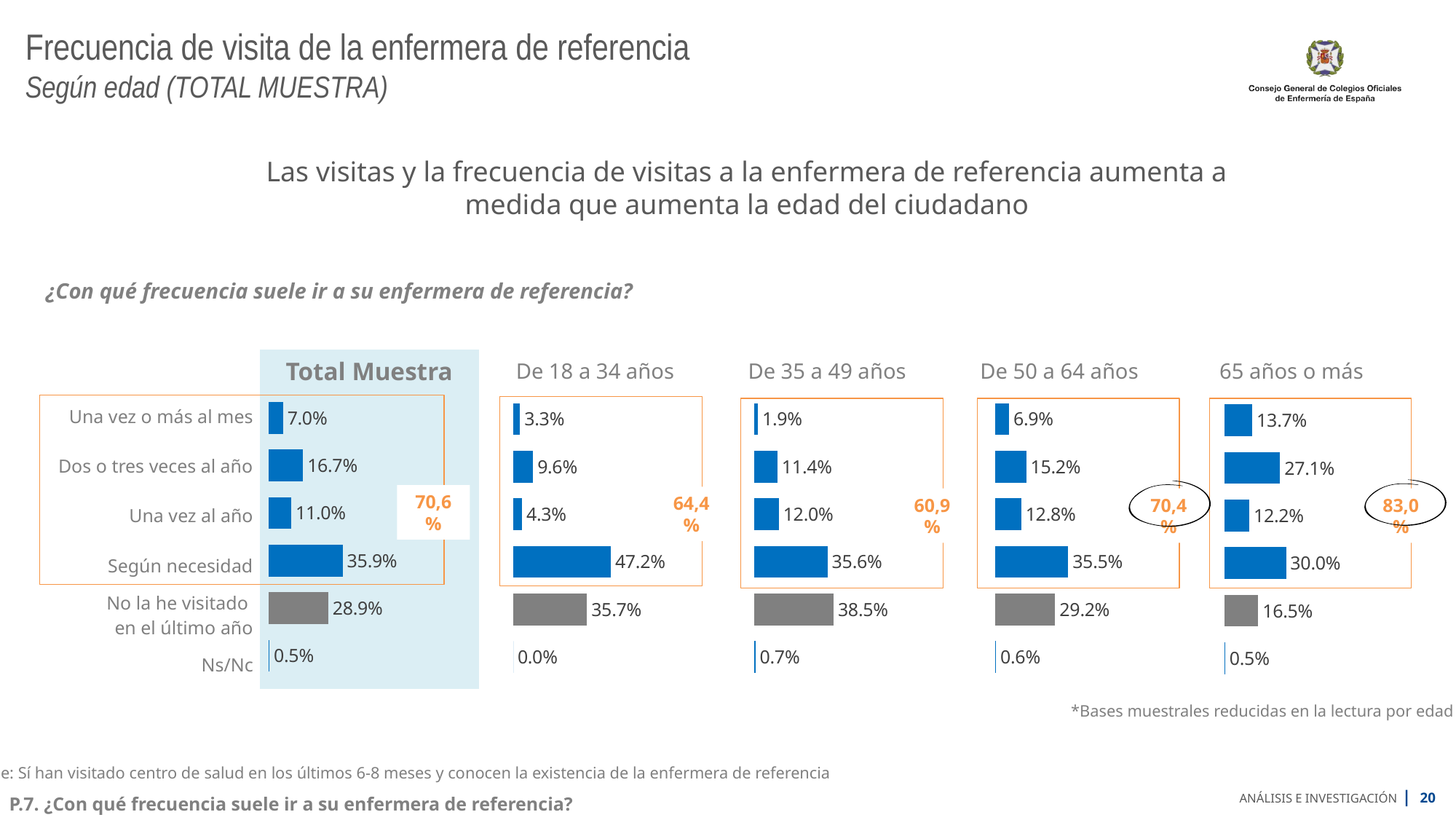
In the 'De 50 a 64 años' chart, which category has the lowest value? Ns/Nc Which is larger: 'Una vez o más al mes' in the 'De 18 a 34 años' chart or 'Una vez o más al mes' in the '65 años o más' chart? 65 años o más In the '65 años o más' chart, what is the value for 'Dos o tres veces al año'? 27.1% In the 'De 18 a 34 años' chart, what is the value for 'Ns/Nc'? 0.0% How many categories does each chart on the slide show? 6 In the '65 años o más' chart, what is the difference between 'Según necesidad' and 'No la he visitado en el último año'? 13.5% In the 'De 50 a 64 años' chart, what is the difference between 'Dos o tres veces al año' and 'Una vez al año'? 2.4% In the 'De 35 a 49 años' chart, which category has the highest value? No la he visitado en el último año What kind of chart is used for the 'Total Muestra' data? Bar chart How many charts are shown on the slide? 5 In the 'Total Muestra' chart, what is the value for 'Según necesidad'? 35.9% In the 'De 18 a 34 años' chart, what is the value for 'No la he visitado en el último año'? 35.7%